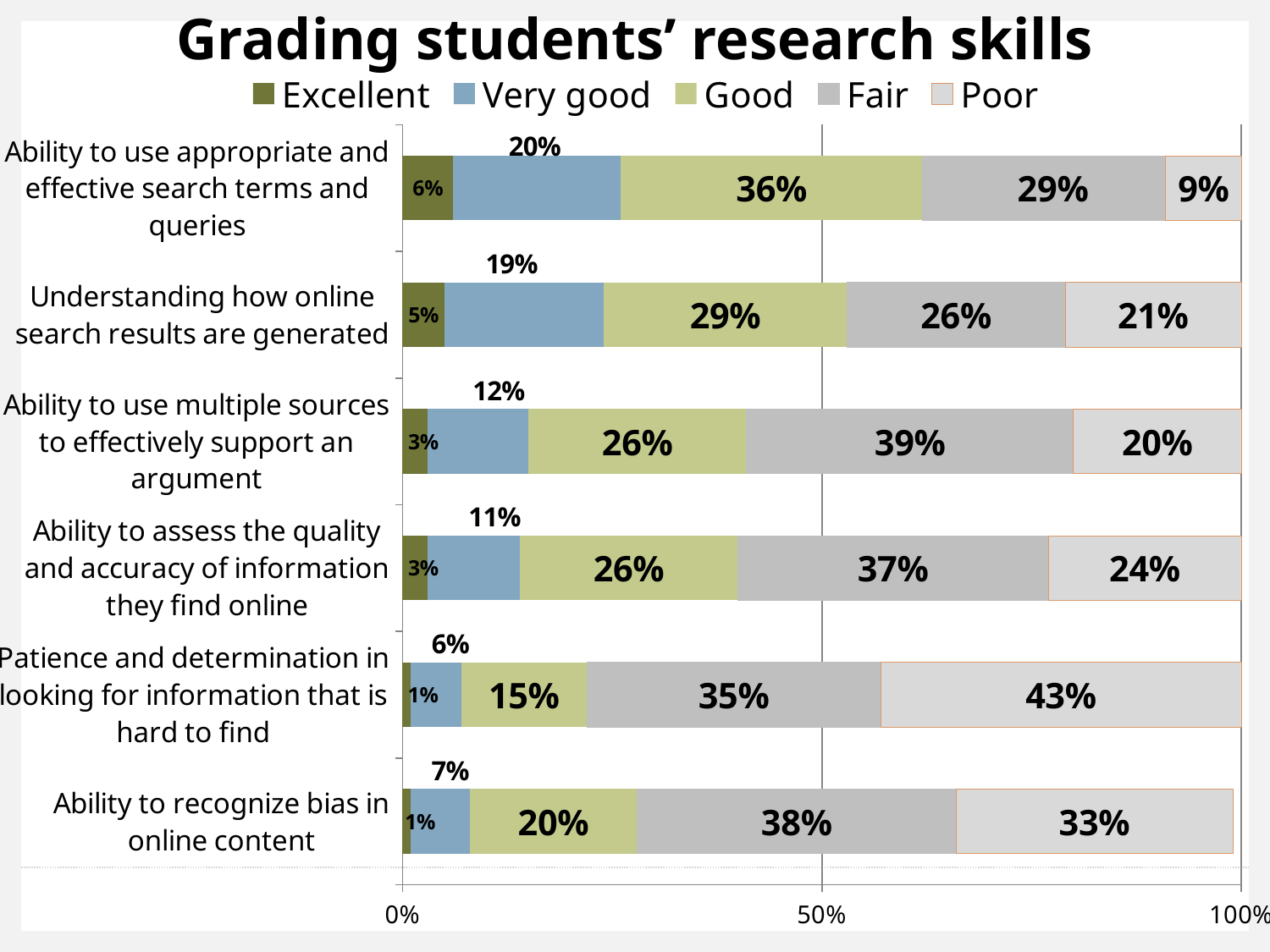
What is the title of the chart? Grading students' research skills What kind of chart is shown on the slide? Stacked bar chart Which is larger: the Excellent value for 'Ability to use appropriate and effective search terms and queries' or the Excellent value for 'Understanding how online search results are generated'? Ability to use appropriate and effective search terms and queries What is the difference between the Fair values for 'Ability to use multiple sources to effectively support an argument' and 'Ability to recognize bias in online content'? 1% Which skill has the lowest Good percentage? Patience and determination in looking for information that is hard to find What is the Poor value for 'Patience and determination in looking for information that is hard to find'? 43% How many series does the legend list? 5 What is the total of the stacked bar for 'Ability to recognize bias in online content'? 99% How many skill categories are plotted in the chart? 6 What percentage of respondents rated students' ability to use appropriate and effective search terms and queries as Good? 36% What is the Very good value for 'Understanding how online search results are generated'? 19% Which skill has the highest Poor percentage? Patience and determination in looking for information that is hard to find